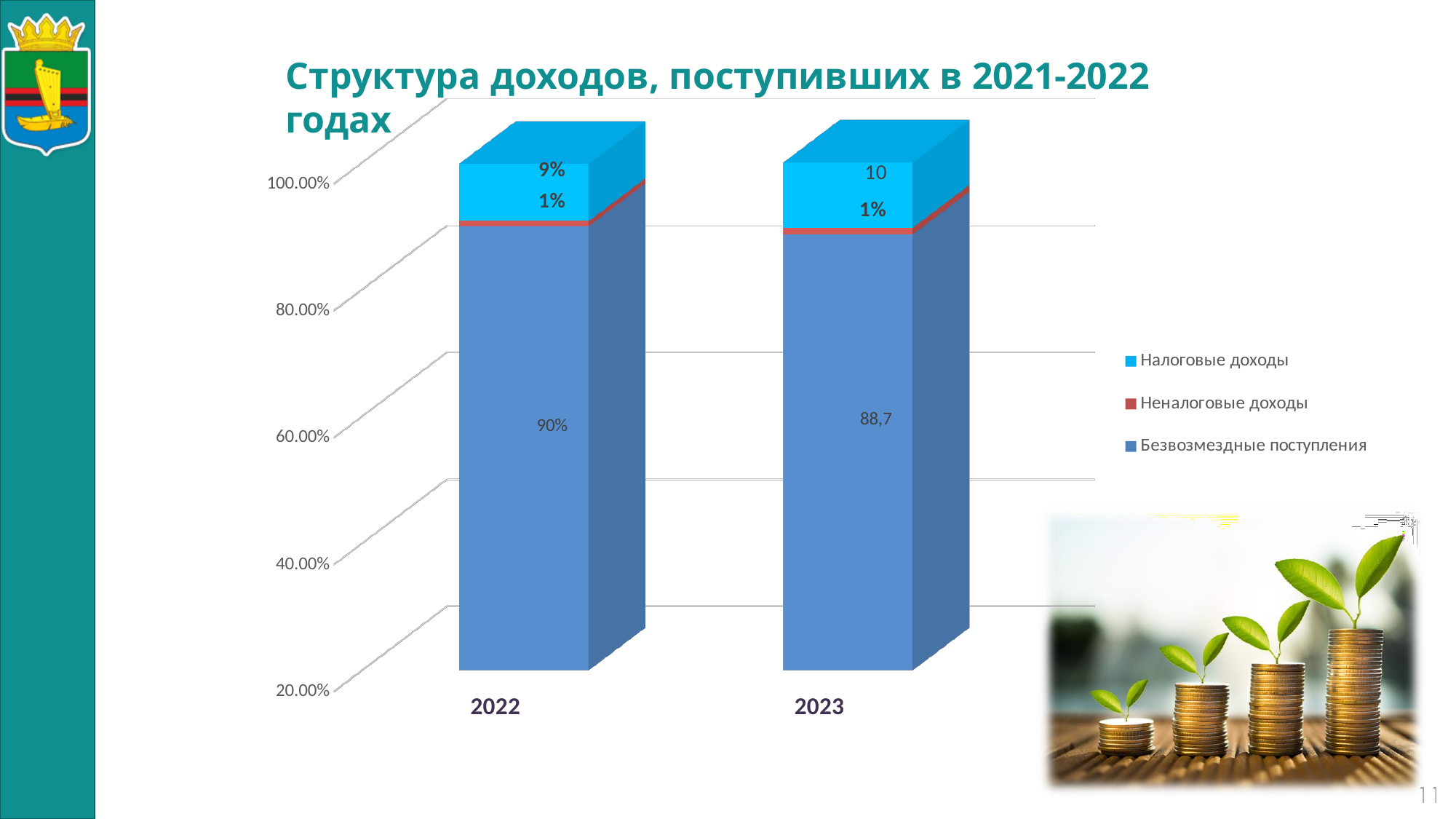
Which legend entry is shown in red? Неналоговые доходы What is the value labelled for Безвозмездные поступления in 2023? 88,7 What is the value labelled for Безвозмездные поступления in 2022? 90% How many series does the legend list? 3 What is the value labelled for Налоговые доходы in 2023? 10 Which year has the larger share of Безвозмездные поступления, 2022 or 2023? 2022 What is the title of the chart? Структура доходов, поступивших в 2021-2022 годах What kind of chart is shown on the slide? Stacked bar chart What is the value labelled for Неналоговые доходы in 2023? 1% What is the value labelled for Налоговые доходы in 2022? 9% Which series has the smallest share in 2022? Неналоговые доходы How many categories (years) are shown on the x axis? 2